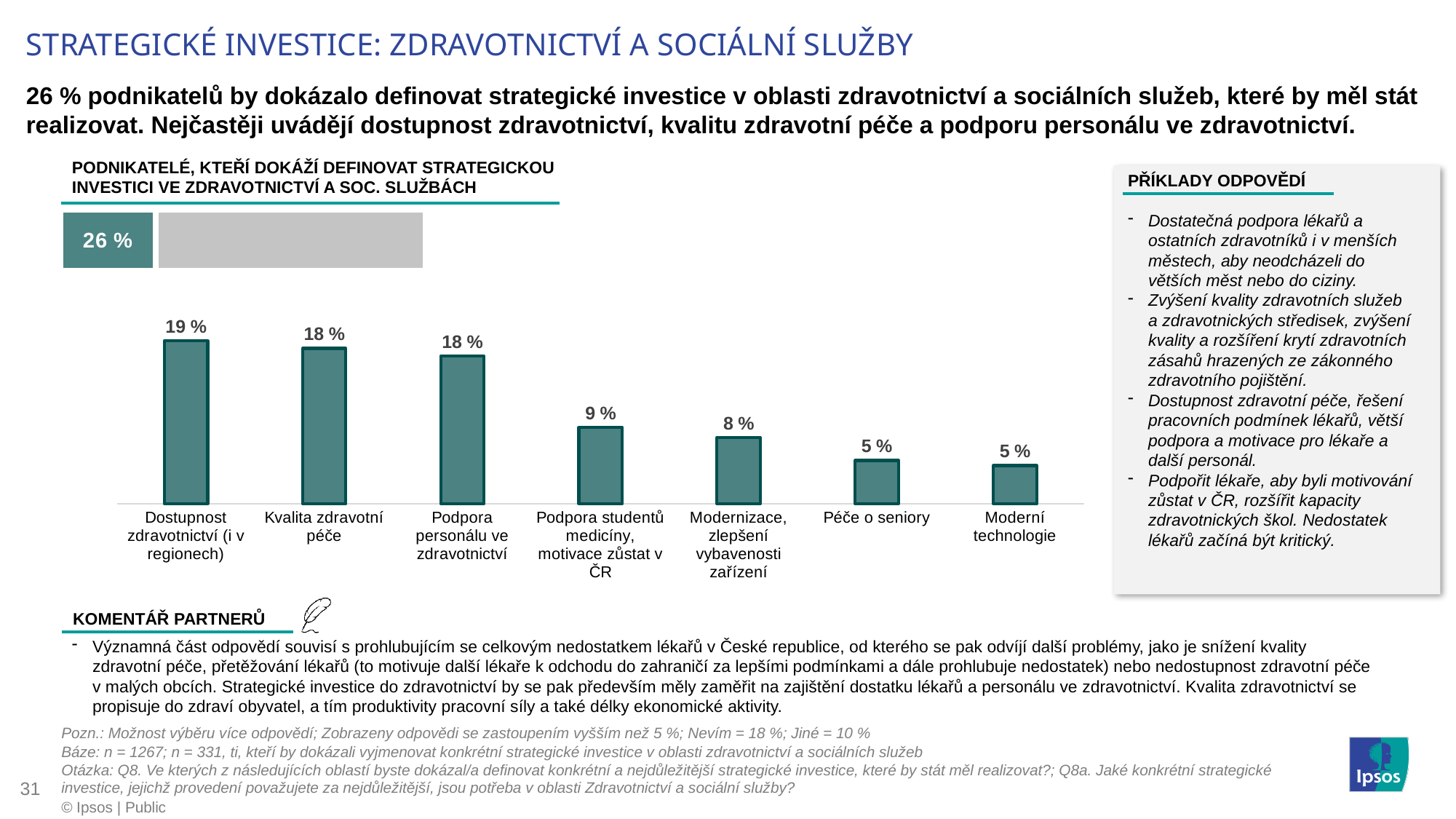
How many categories are shown in the bar chart? 7 Which is larger: the value for Kvalita zdravotní péče or the value for Modernizace, zlepšení vybavenosti zařízení? Kvalita zdravotní péče What is the value for Podpora studentů medicíny, motivace zůstat v ČR? 9 % What is the value for Dostupnost zdravotnictví (i v regionech) in the bar chart? 19 % Do the values in the bar chart rise or fall from left to right? Fall What is the difference between the values for Dostupnost zdravotnictví (i v regionech) and Podpora studentů medicíny, motivace zůstat v ČR? 10 % What is the difference between the values for Podpora personálu ve zdravotnictví and Moderní technologie? 13 % What percentage of entrepreneurs can define a strategic investment in healthcare and social services, according to the highlighted bar above the chart? 26 % What kind of chart is used to show the categories from Dostupnost zdravotnictví to Moderní technologie? Bar chart Which category has the highest value in the bar chart? Dostupnost zdravotnictví (i v regionech) What is the value for Modernizace, zlepšení vybavenosti zařízení? 8 % What is the value for Péče o seniory? 5 %